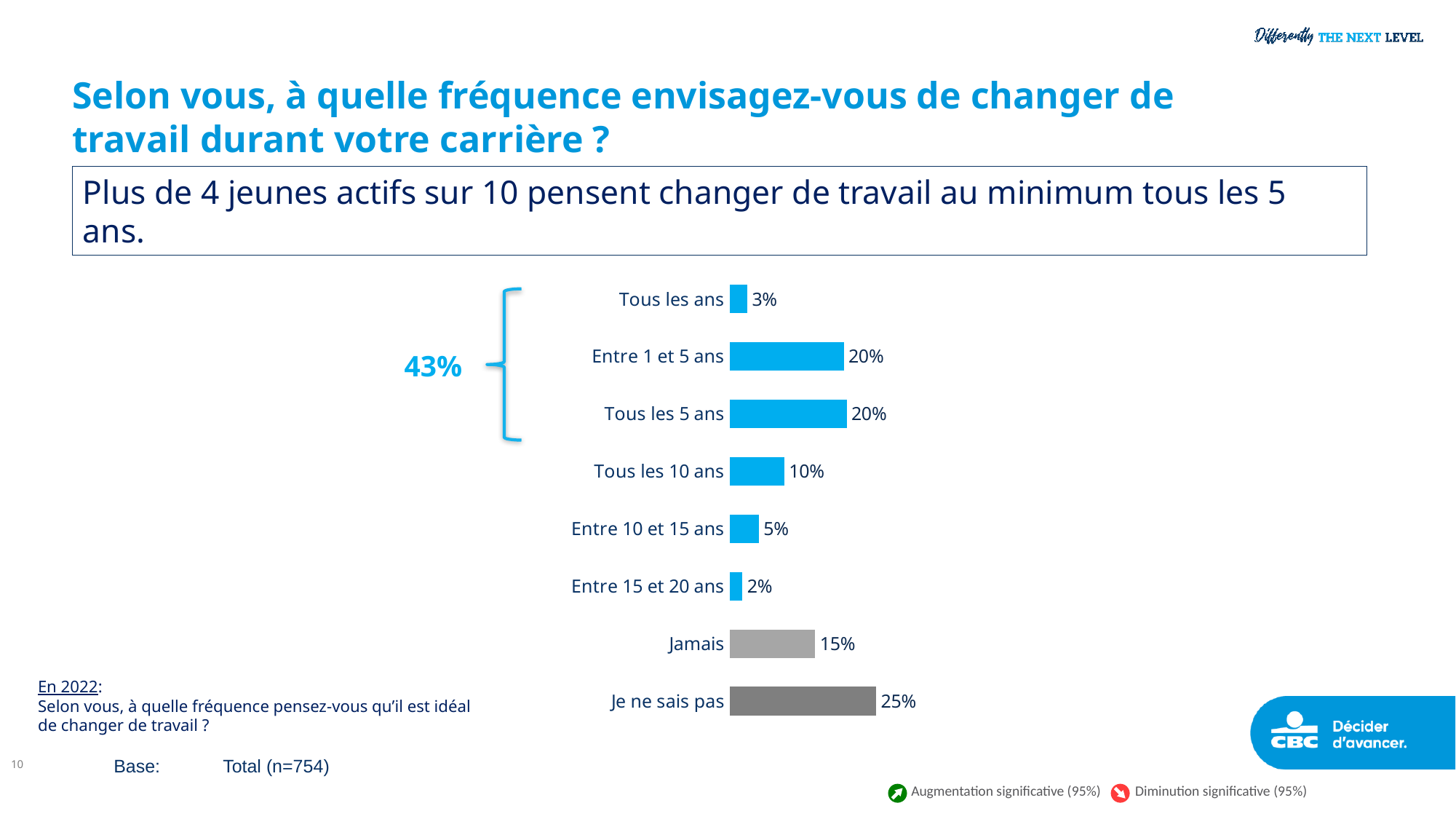
Which is larger, the value for "Tous les 10 ans" or the value for "Jamais"? Jamais Which category has the lowest value? Entre 15 et 20 ans What kind of chart is shown on the slide? Bar chart How many categories are shown in the chart? 8 What is the value shown for "Je ne sais pas"? 25% Which category has the highest value? Je ne sais pas What percentage is shown for "Entre 10 et 15 ans"? 5% Which two categories are shown with grey bars instead of blue? Jamais and Je ne sais pas What is the combined total of "Tous les ans", "Entre 1 et 5 ans" and "Tous les 5 ans" as indicated by the bracket? 43% What is the difference between the values for "Je ne sais pas" and "Jamais"? 10% What is the base (sample size) shown for the chart? Total (n=754) What percentage of respondents answered "Tous les 5 ans"? 20%